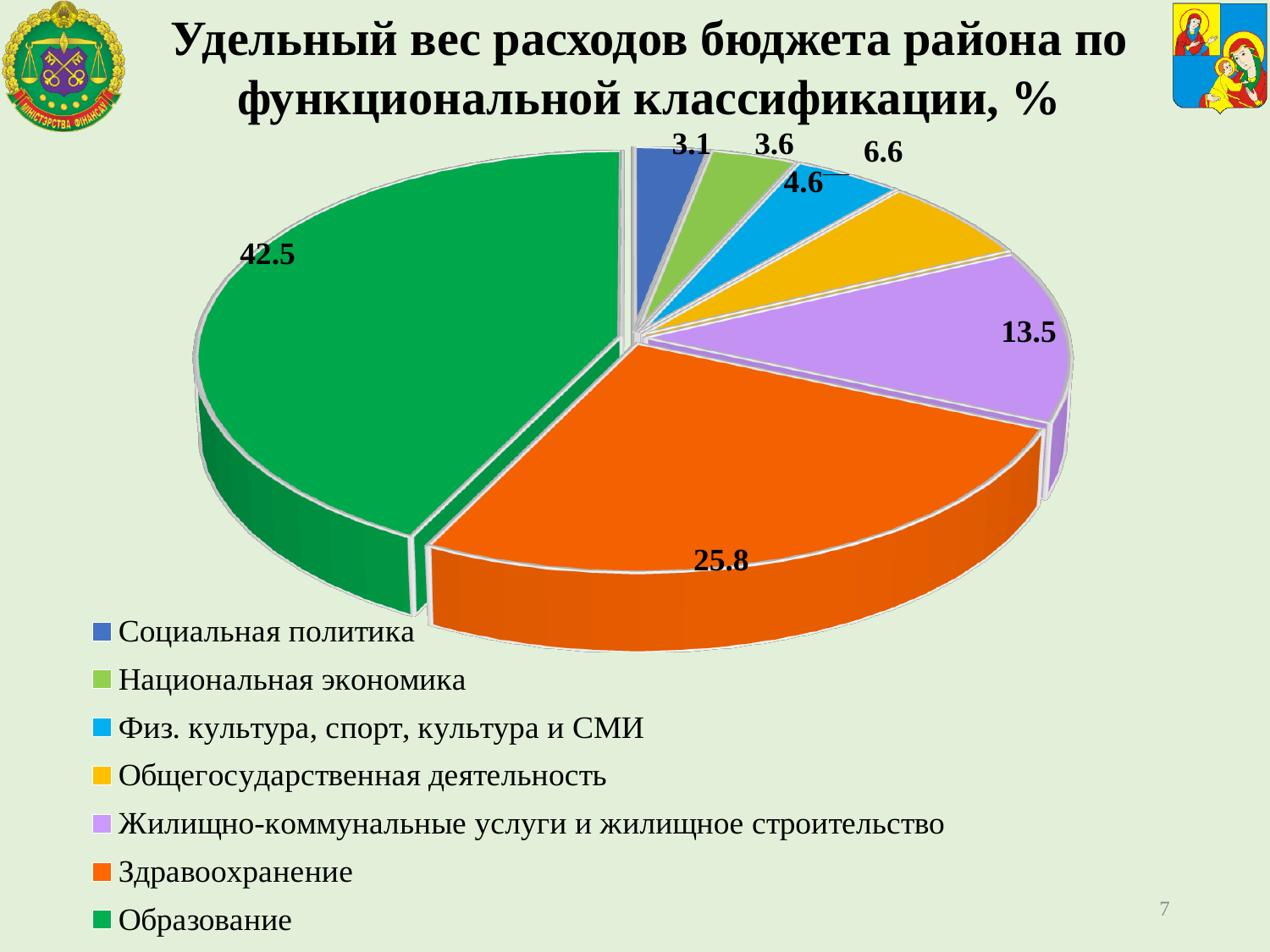
How many categories does the legend list? 7 What is the value for Общегосударственная деятельность? 6.6 What is the value for Образование? 42.5 What kind of chart is shown on the slide? pie chart Which category has the smallest share of the pie? Социальная политика What colour is the slice for Здравоохранение? orange What is the difference between the values for Образование and Здравоохранение? 16.7 Which category has the largest share of the pie? Образование What is the value for Социальная политика? 3.1 What is the value for Жилищно-коммунальные услуги и жилищное строительство? 13.5 Which is larger, the value for Физ. культура, спорт, культура и СМИ or the value for Национальная экономика? Физ. культура, спорт, культура и СМИ What is the value for Здравоохранение? 25.8